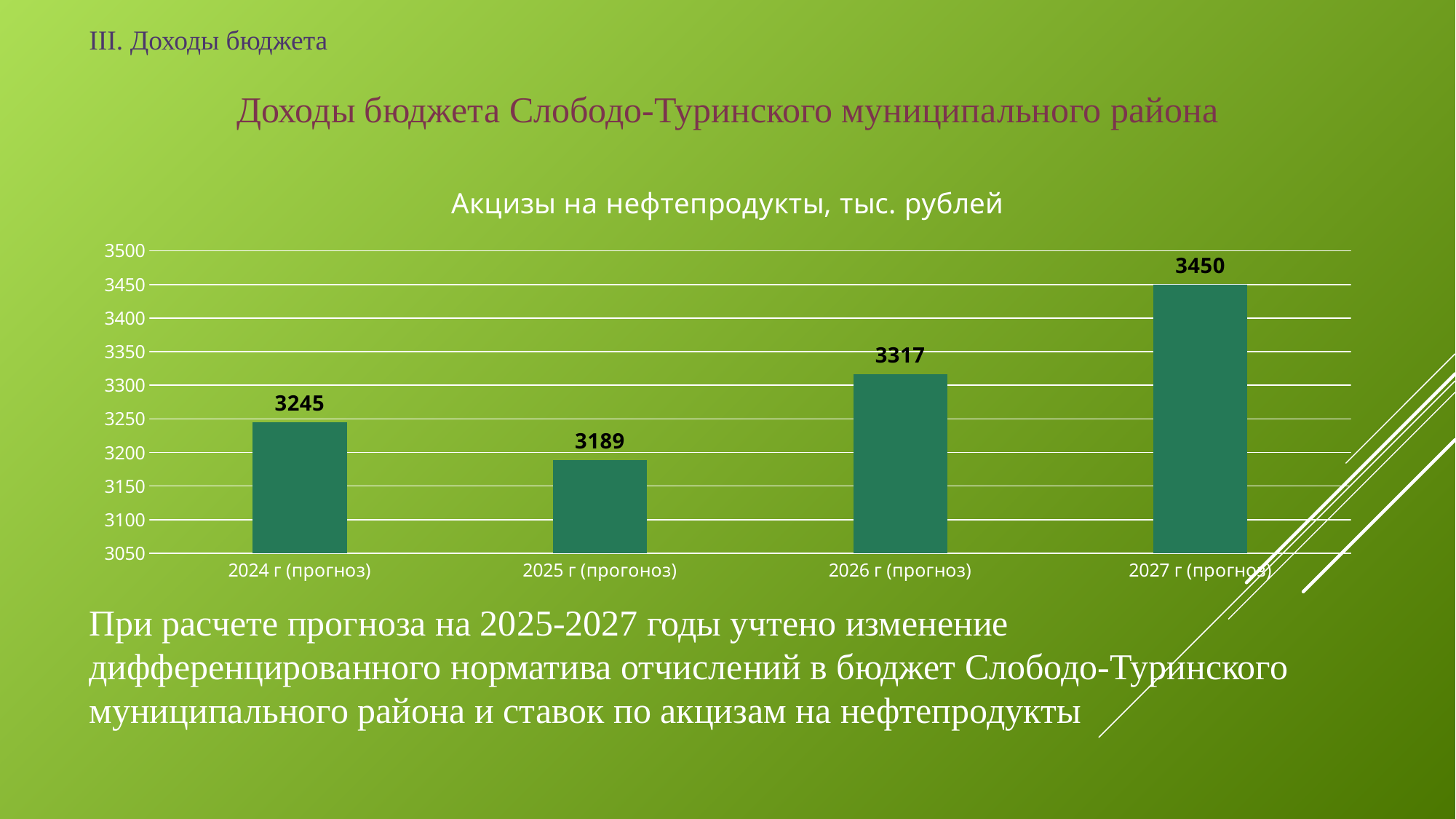
Which is larger, the value for 2026 г (прогноз) or the value for 2024 г (прогноз)? 2026 г (прогноз) What is the value for 2024 г (прогноз)? 3245 What is the difference between the values for 2027 г (прогноз) and 2024 г (прогноз)? 205 What is the title of the chart? Акцизы на нефтепродукты, тыс. рублей What kind of chart is shown on the slide? bar chart What is the value for 2027 г (прогноз)? 3450 What is the value for 2026 г (прогноз)? 3317 Which year has the highest value? 2027 г (прогноз) How many bars are shown in the chart? 4 What is the value for 2025 г (прогоноз)? 3189 Which year has the lowest value? 2025 г (прогоноз) Is the value for 2025 г (прогоноз) greater or less than 3200? less